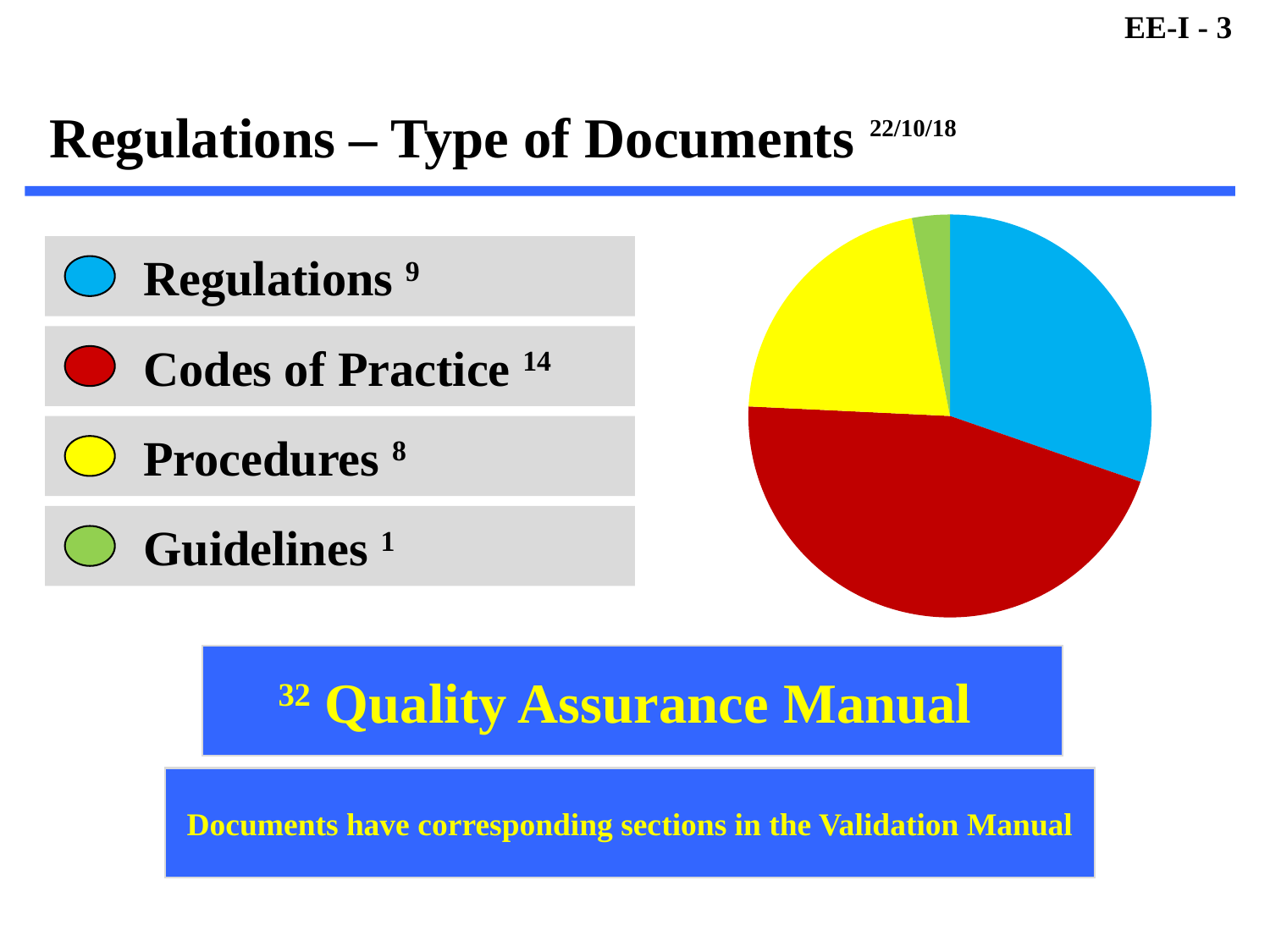
Which document type has the smallest slice of the pie? Guidelines Which document type has the largest slice of the pie? Codes of Practice How many slices does the pie chart have? 4 What is the value for Regulations? 9 What is the difference between the values for Codes of Practice and Regulations? 5 What is the value for Guidelines? 1 What is the value for Codes of Practice? 14 What kind of chart is shown on the slide? pie chart Which colour represents Codes of Practice in the pie chart? red What is the value for Procedures? 8 Which is larger, the value for Regulations or the value for Procedures? Regulations